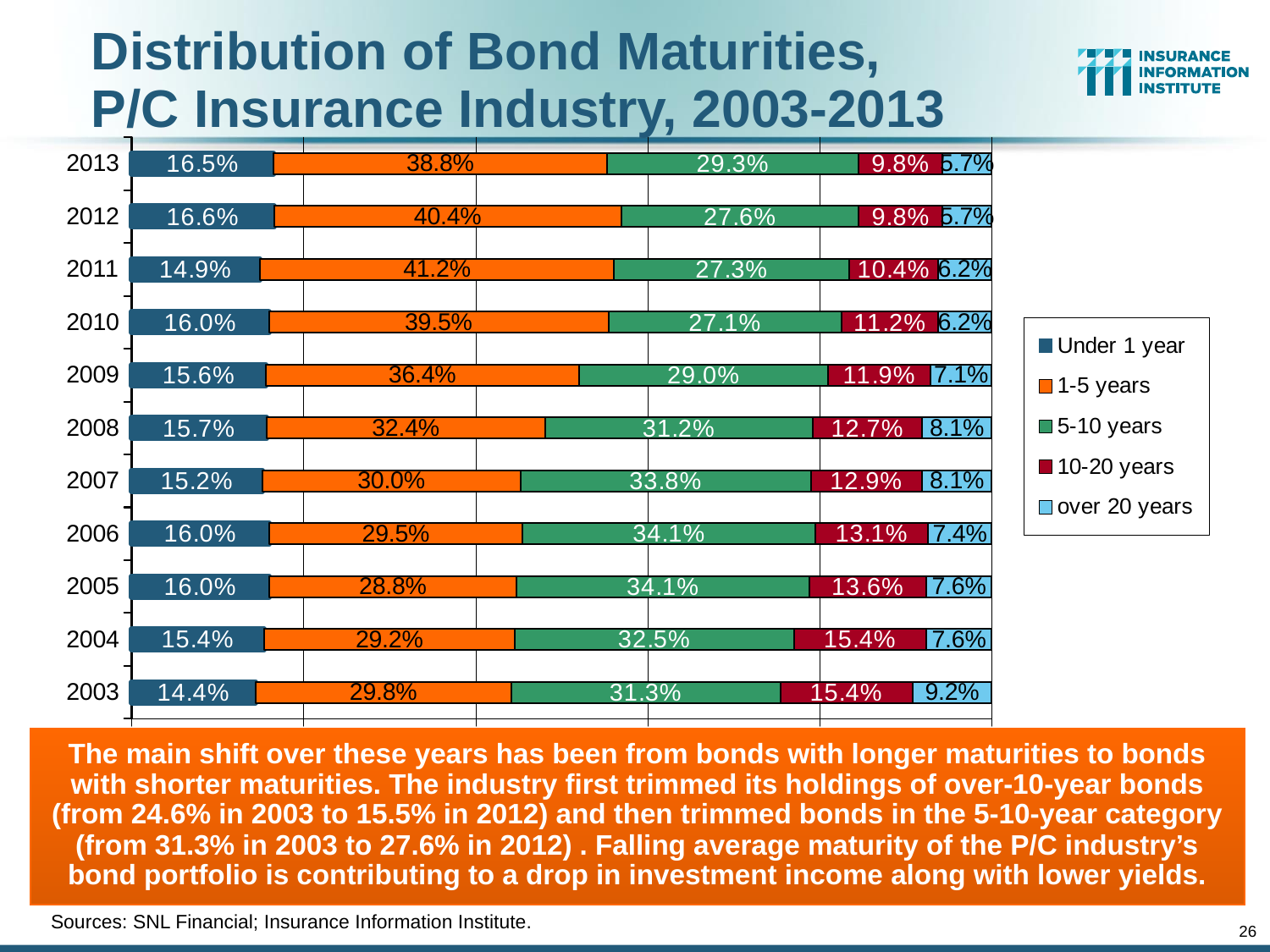
What kind of chart is shown on the slide? Stacked bar chart Which year has the highest share of bonds in the 1-5 years category? 2011 What colour represents the 1-5 years category in the chart? Orange By how many percentage points did the 10-20 years share fall from 2003 to 2013? 5.6 percentage points Which year had a larger share of 5-10 year bonds, 2006 or 2013? 2006 What share of bonds had maturities under 1 year in 2009? 15.6% What share of bonds had maturities of 5-10 years in 2003? 31.3% Which year has the highest share of bonds in the over 20 years category? 2003 Does the share of 1-5 year bonds generally rise or fall from 2003 to 2013? Rises What share of bonds had maturities of 1-5 years in 2011? 41.2% How many years are shown on the chart? 11 How many series does the legend list? 5